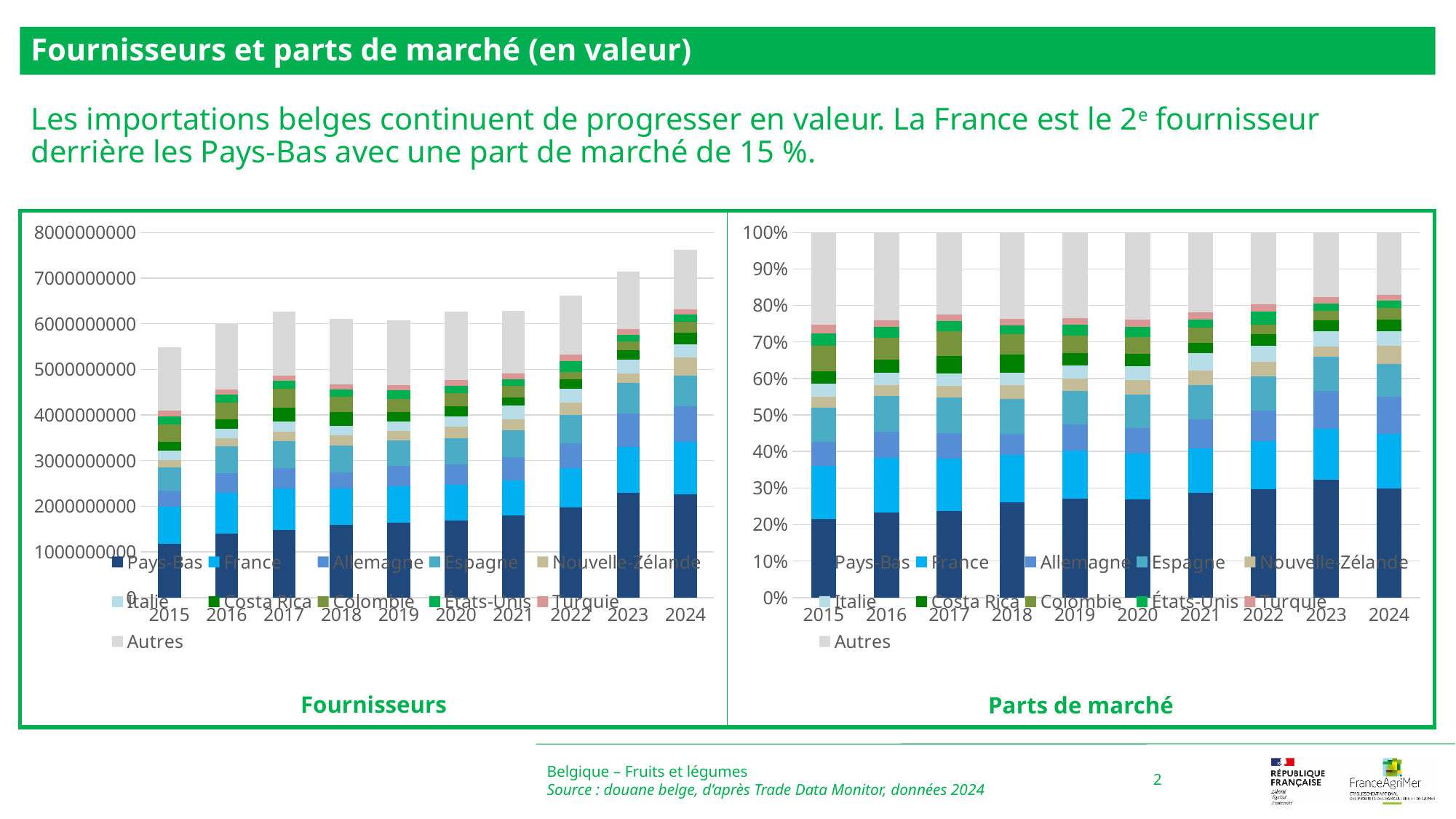
In the 'Parts de marché' chart, is the Pays-Bas share for 2023 greater or less than 40%? less How many years are shown on the x axis of the 'Fournisseurs' chart? 10 In the 'Fournisseurs' chart, which year has the highest total bar? 2024 In the 'Fournisseurs' chart, is the total bar for 2024 greater or less than 7000000000? greater How many series does the legend of the 'Parts de marché' chart list? 11 What kind of chart is the 'Fournisseurs' chart on the left? stacked bar chart In the 'Fournisseurs' chart, is the total bar for 2015 greater or less than 6000000000? less In the 'Fournisseurs' chart, which year has the lowest total bar? 2015 In the 'Parts de marché' chart, which series is shown at the bottom of each stacked bar? Pays-Bas In the 'Fournisseurs' chart, do the total bars generally rise or fall from 2015 to 2024? rise In the 'Fournisseurs' chart, which total bar is larger, 2023 or 2024? 2024 What is the title of the chart on the right of the slide? Parts de marché